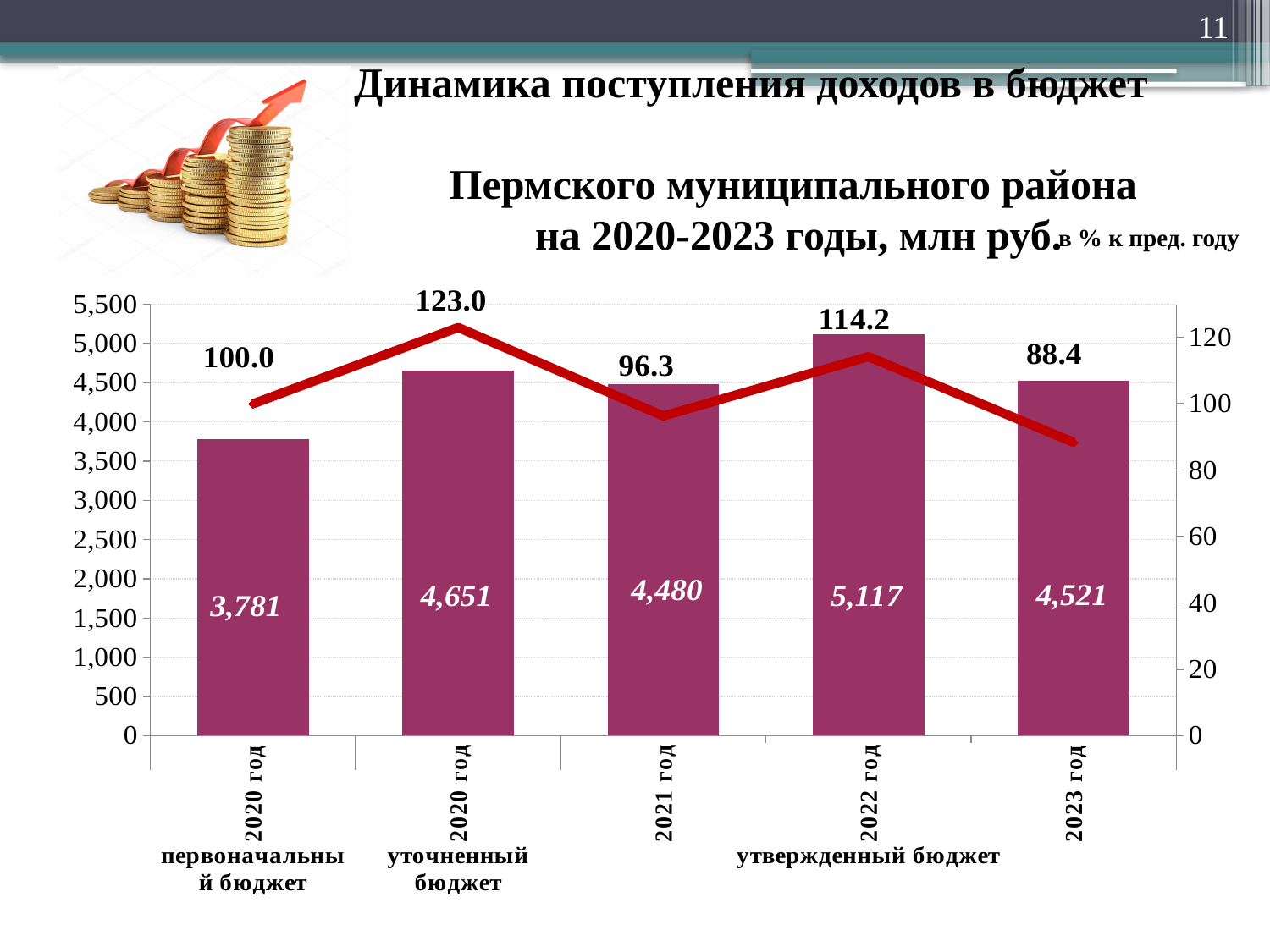
Which category has the highest budget revenue bar? 2022 год Which is larger: the budget revenue for 2021 год or for 2023 год? 2023 год What kind of chart is shown on the slide? Combined bar and line chart Which category has the lowest value on the red line (в % к пред. году)? 2023 год What percentage to the previous year (в % к пред. году) is shown for 2023 год? 88.4 Which category has the lowest budget revenue bar? 2020 год первоначальный бюджет Is the budget revenue bar for 2020 год первоначальный бюджет greater or less than 4,000? less What is the budget revenue value (млн руб.) shown for 2022 год? 5,117 What is the budget revenue value (млн руб.) shown for 2020 год первоначальный бюджет? 3,781 What is the difference between the budget revenue for 2022 год and 2023 год? 596 What percentage to the previous year is shown for 2020 год уточненный бюджет? 123.0 How many bars are plotted in the chart? 5